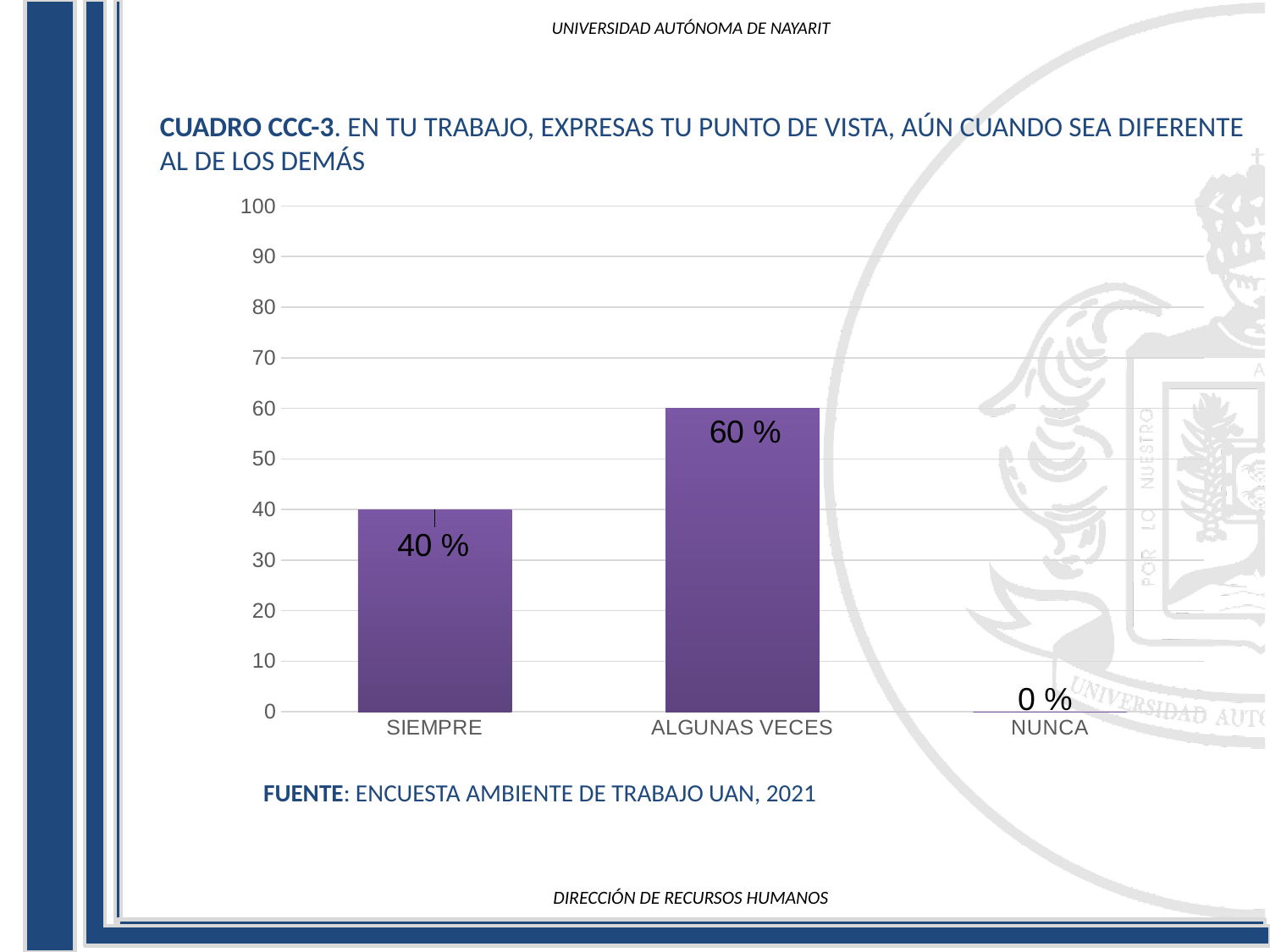
How many categories are shown on the x axis? 3 Which is larger, the value for SIEMPRE or the value for ALGUNAS VECES? ALGUNAS VECES What is the value for SIEMPRE? 40 % What is the difference between the values for ALGUNAS VECES and SIEMPRE? 20 % Is the value for ALGUNAS VECES greater or less than 50? greater Which category has the lowest value? NUNCA What is the source cited below the chart? ENCUESTA AMBIENTE DE TRABAJO UAN, 2021 Which category has the highest value? ALGUNAS VECES What is the value for ALGUNAS VECES? 60 % What is the highest value shown on the y axis? 100 What kind of chart is shown on the slide? bar chart What is the value for NUNCA? 0 %